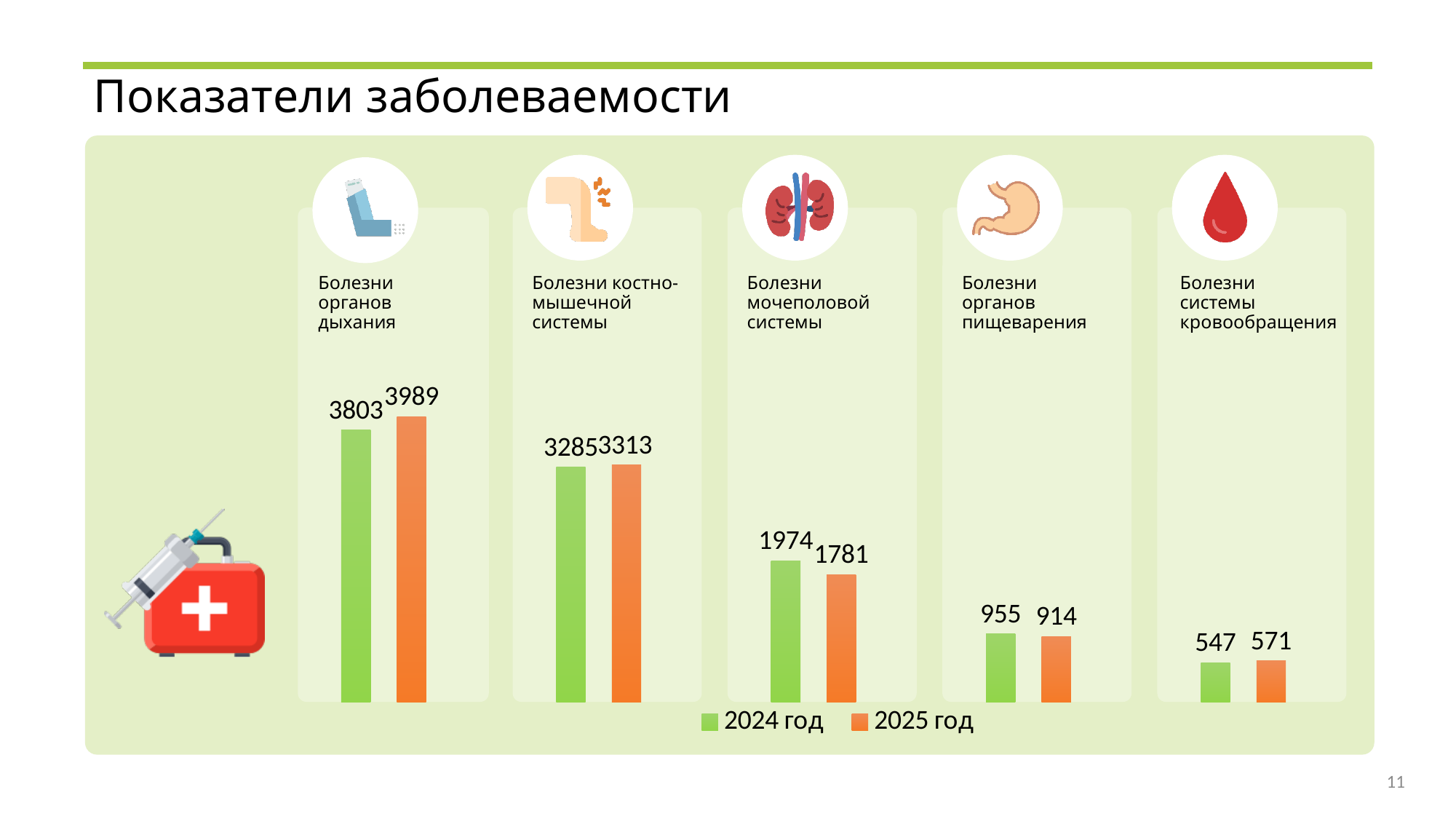
What is the value for Болезни органов дыхания in 2024 год? 3803 What is the difference between the 2025 год and 2024 год values for Болезни органов дыхания? 186 Which category has the highest value in 2025 год? Болезни органов дыхания Which category has the lowest value in 2024 год? Болезни системы кровообращения For Болезни органов пищеварения, which year has the larger value, 2024 год or 2025 год? 2024 год What colour represents 2025 год in the chart? orange What is the difference between the 2024 год and 2025 год values for Болезни мочеполовой системы? 193 How many disease categories are shown in the chart? 5 What is the value for Болезни системы кровообращения in 2024 год? 547 What is the value for Болезни мочеполовой системы in 2025 год? 1781 What kind of chart is shown on the slide? bar chart How many series does the legend list? 2